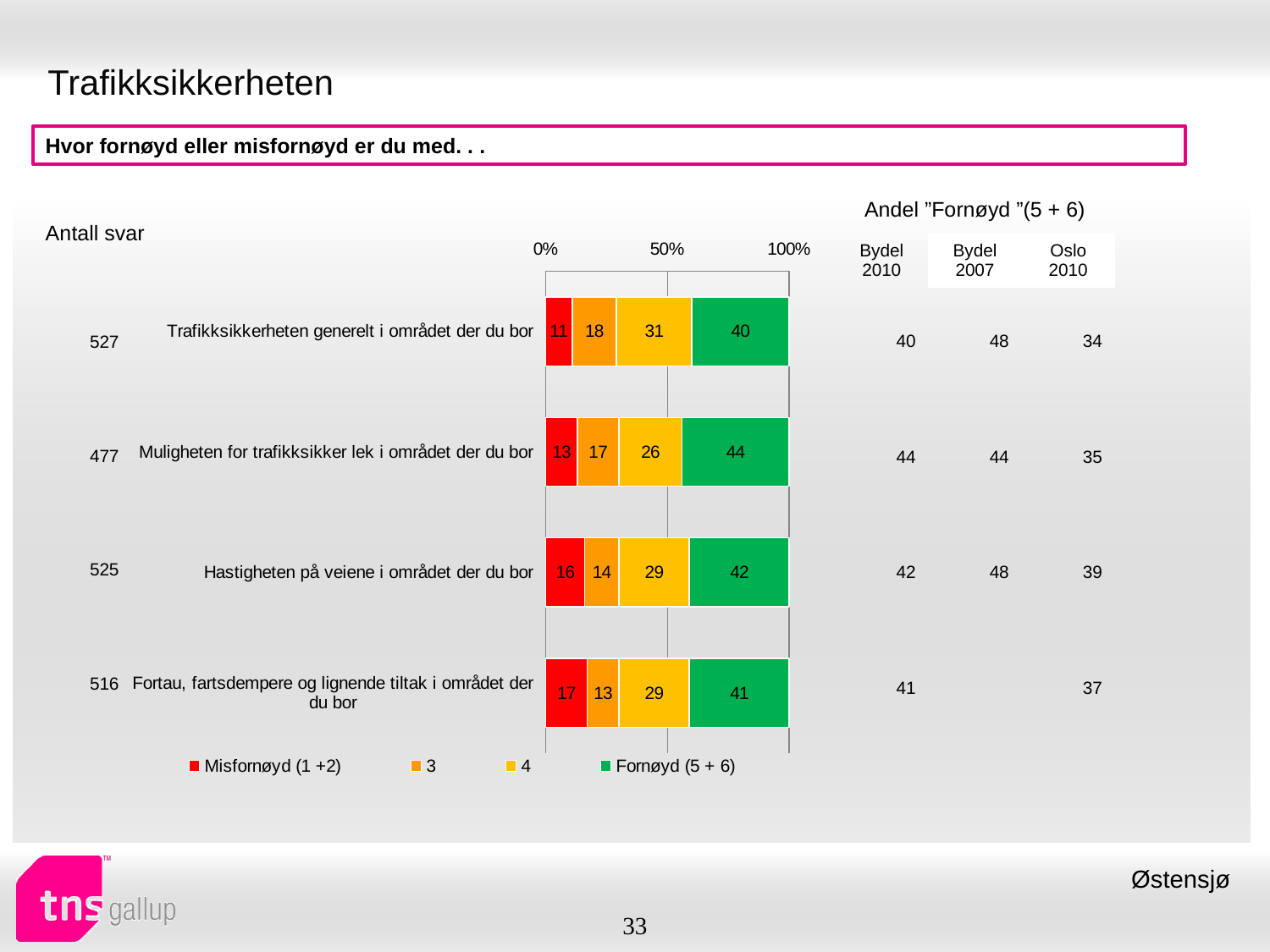
What is the value of "Fornøyd (5 + 6)" for "Trafikksikkerheten generelt i området der du bor"? 40 What is the difference between the "Fornøyd (5 + 6)" values for "Muligheten for trafikksikker lek i området der du bor" and "Trafikksikkerheten generelt i området der du bor"? 4 What is the total of the stacked bar for "Hastigheten på veiene i området der du bor"? 101 What is the value of "Misfornøyd (1 +2)" for "Hastigheten på veiene i området der du bor"? 16 What is the value of series "4" for "Muligheten for trafikksikker lek i området der du bor"? 26 Which is larger: the "Misfornøyd (1 +2)" value for "Fortau, fartsdempere og lignende tiltak i området der du bor" or for "Muligheten for trafikksikker lek i området der du bor"? Fortau, fartsdempere og lignende tiltak i området der du bor What kind of chart is shown on the slide? Stacked bar chart Which colour represents "Fornøyd (5 + 6)" in the chart? Green How many series does the legend list? 4 How many categories are shown in the chart? 4 Which category has the lowest "Misfornøyd (1 +2)" value? Trafikksikkerheten generelt i området der du bor Which category has the highest "Fornøyd (5 + 6)" value? Muligheten for trafikksikker lek i området der du bor